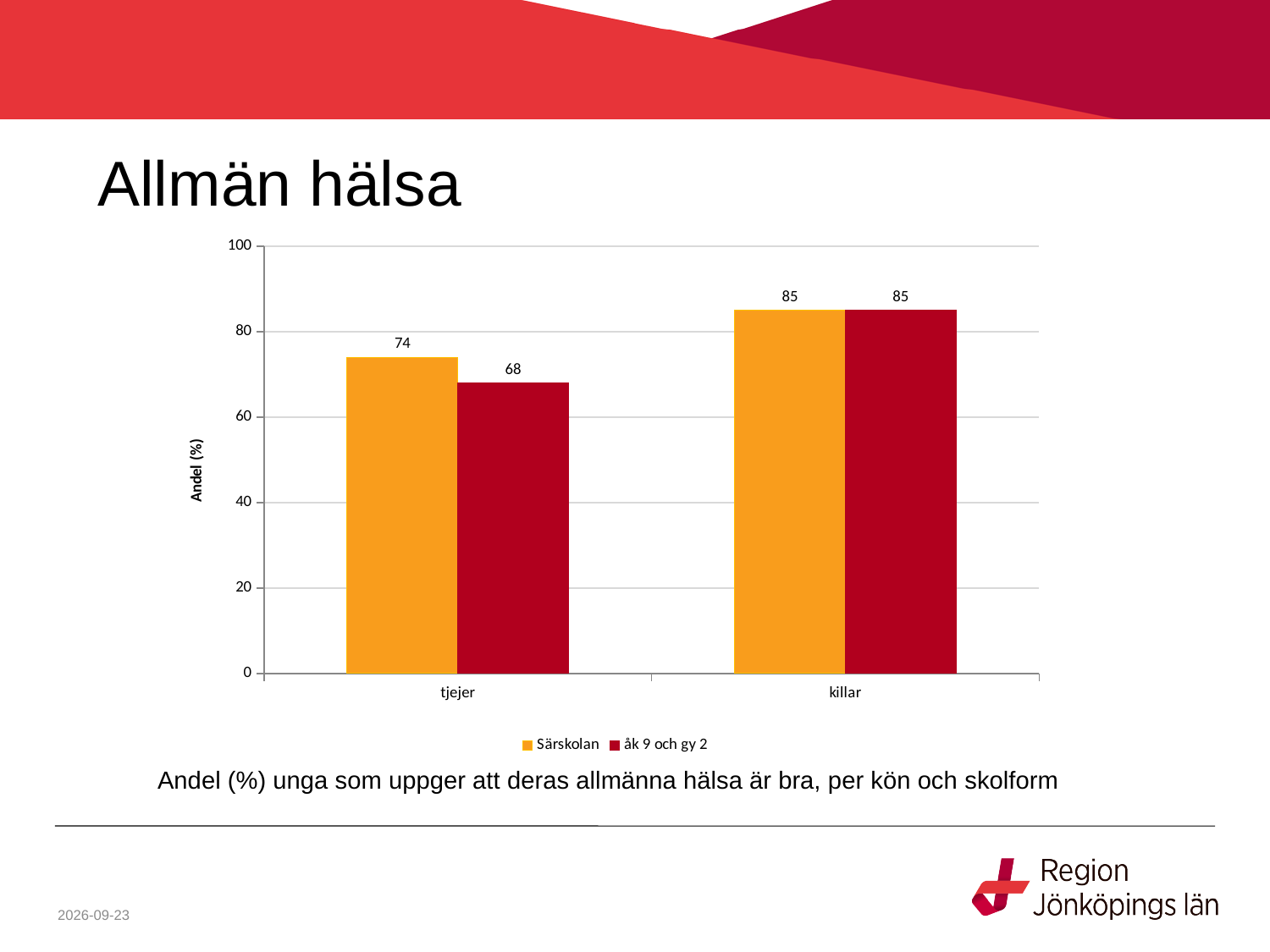
What is the value for åk 9 och gy 2 in the killar category? 85 What is the value for Särskolan in the killar category? 85 What is the difference between the Särskolan values for killar and tjejer? 11 What kind of chart is shown on the slide? bar chart How many categories are shown on the x axis? 2 Which category has the lowest value for the åk 9 och gy 2 series? tjejer What is the value for åk 9 och gy 2 in the tjejer category? 68 Which is larger for tjejer: the Särskolan value or the åk 9 och gy 2 value? Särskolan What is the label of the y axis? Andel (%) What is the difference between the Särskolan and åk 9 och gy 2 values for tjejer? 6 What is the value for Särskolan in the tjejer category? 74 How many series does the legend list? 2